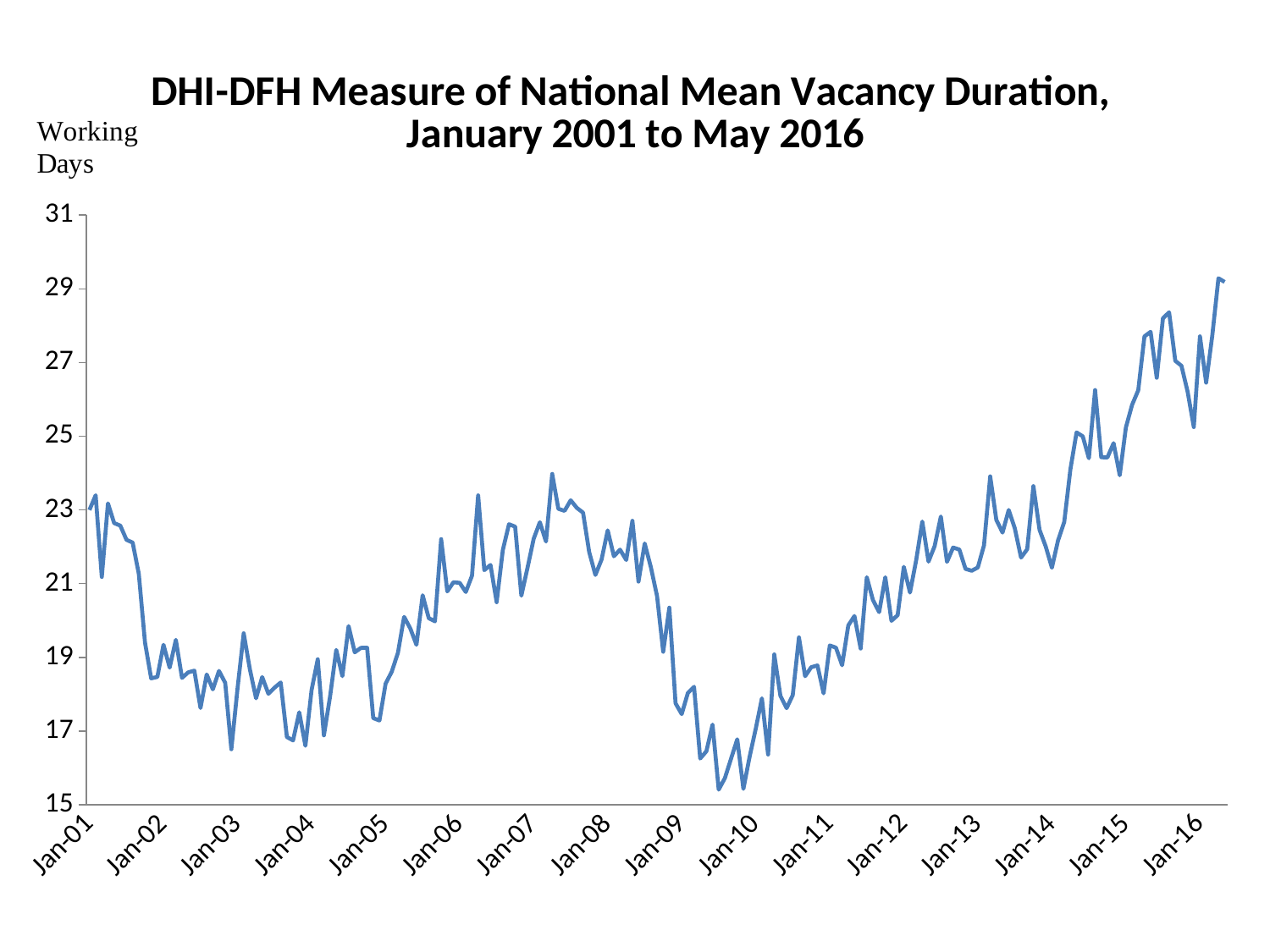
What unit is the vertical axis labelled with? Working Days What is the title of the chart? DHI-DFH Measure of National Mean Vacancy Duration, January 2001 to May 2016 Is the value at Jan-04 greater or less than 19? less Near which x-axis label does the line reach its lowest point? Jan-10 Is the value at Jan-12 greater or less than 23? less Is the value at Jan-15 greater or less than 23? greater Between Jan-10 and the end of the series, does the line generally rise or fall? rise What kind of chart is shown on the slide? line chart How many labelled tick marks are there on the x axis? 16